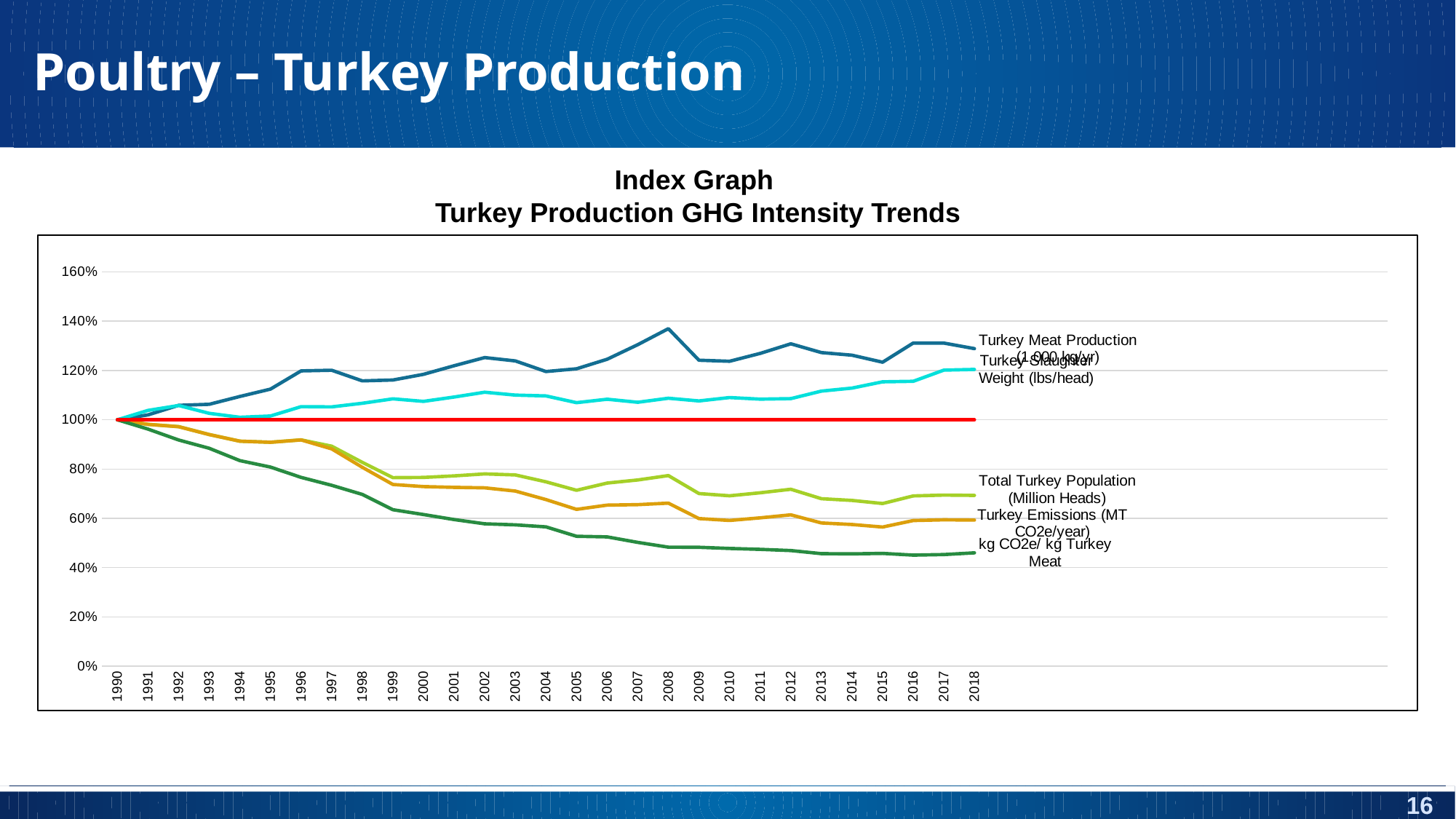
Which series has the lowest value in 2018? kg CO2e/ kg Turkey Meat In 2018, which is larger: Total Turkey Population (Million Heads) or Turkey Emissions (MT CO2e/year)? Total Turkey Population (Million Heads) Does the kg CO2e/ kg Turkey Meat line rise or fall from 1990 to 2018? fall What kind of chart is shown on the slide? line chart Which series has the highest value in 2018? Turkey Meat Production (1,000 kg/yr) What is the title of the chart? Index Graph Turkey Production GHG Intensity Trends How many years are shown along the x axis of the chart? 29 What is the index value of Turkey Meat Production (1,000 kg/yr) in 1990? 100% Does the Turkey Meat Production (1,000 kg/yr) line rise or fall from 1990 to 2018? rise Is the value for Turkey Meat Production (1,000 kg/yr) in 2008 greater or less than 120%? greater Is the value for Total Turkey Population (Million Heads) in 2018 greater or less than 80%? less Is the value for kg CO2e/ kg Turkey Meat in 2018 greater or less than 60%? less